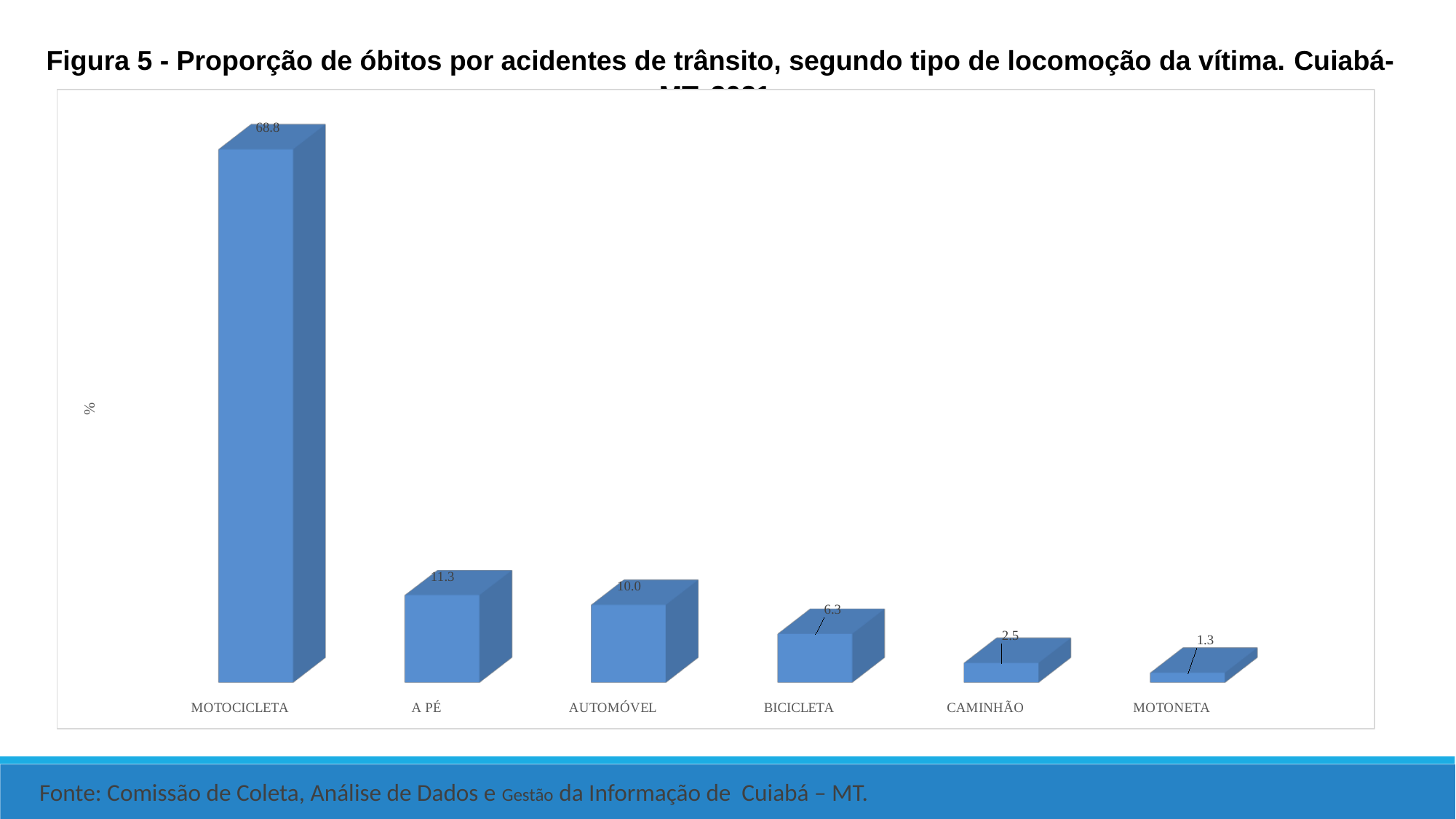
What is the value for CAMINHÃO? 2.5 What is the value for MOTOCICLETA? 68.8 Which category has the lowest value? MOTONETA How many categories are shown on the x axis? 6 What is the difference between the values for MOTOCICLETA and A PÉ? 57.5 What kind of chart is shown on the slide? Bar chart What is the value for AUTOMÓVEL? 10.0 Which is larger, the value for BICICLETA or the value for CAMINHÃO? BICICLETA What is the value for MOTONETA? 1.3 Which category has the highest value? MOTOCICLETA What is the value for A PÉ? 11.3 What is the value for BICICLETA? 6.3